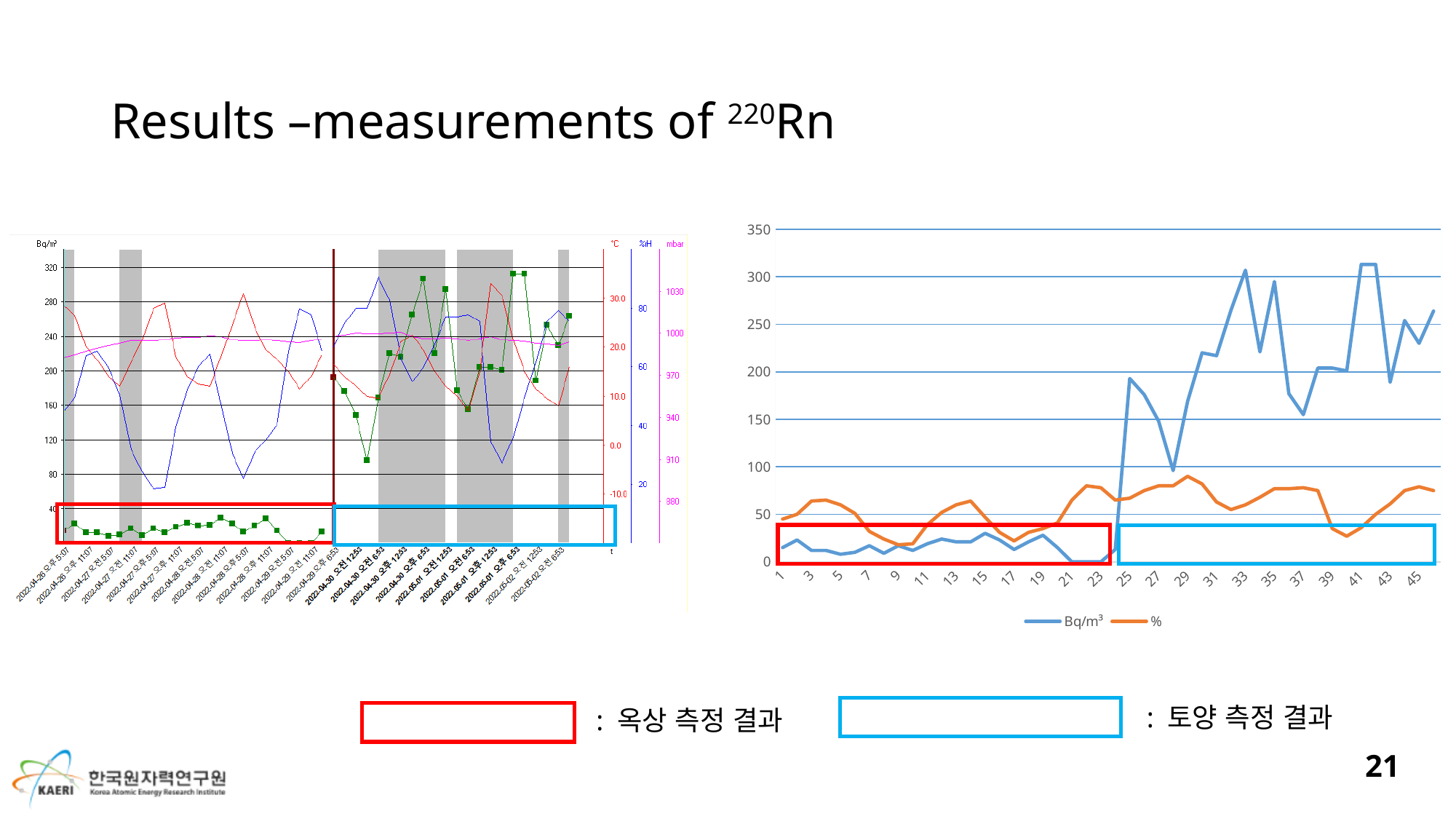
In the right-hand chart, does the Bq/m³ series generally rise or fall from point 1 to point 45? rise What kind of chart is the chart on the right side of the slide? line chart In the right-hand chart, is the Bq/m³ value at point 35 greater or less than 250? greater In the right-hand chart, is the Bq/m³ value at point 1 greater or less than 50? less In the right-hand chart, is the % value at point 29 greater or less than 50? greater How many series does the legend of the right-hand chart list? 2 In the right-hand chart, what is the last label on the horizontal axis? 45 In the right-hand chart, at point 33, which series has the larger value, Bq/m³ or %? Bq/m³ What are the two series named in the legend of the right-hand chart? Bq/m³ and % In the right-hand chart, what is the highest value shown on the vertical axis? 350